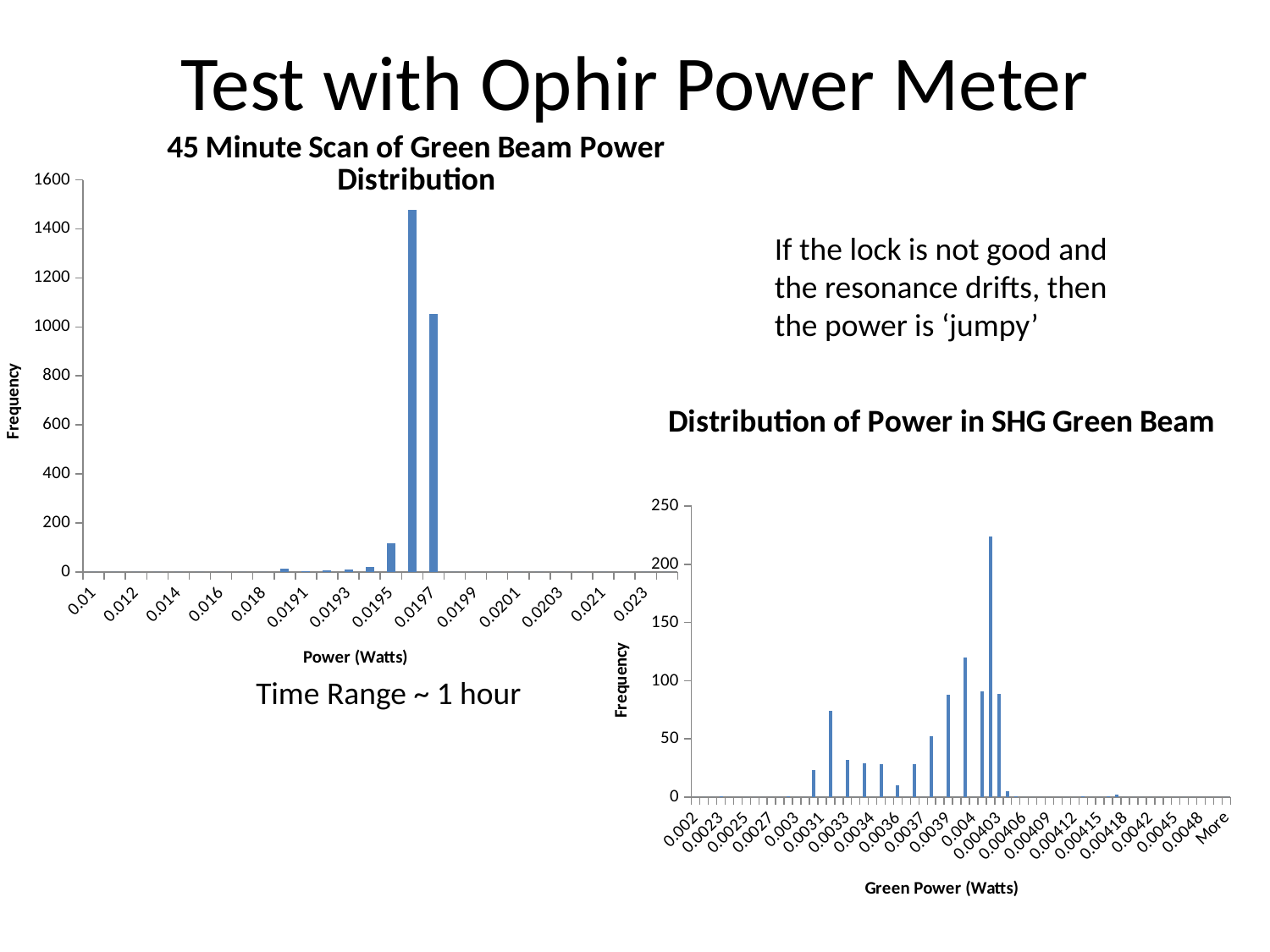
What is the x-axis title of the '45 Minute Scan of Green Beam Power Distribution' chart? Power (Watts) In the 'Distribution of Power in SHG Green Beam' chart, is the bar at 0.0033 greater or less than 50? less What kind of chart is the '45 Minute Scan of Green Beam Power Distribution' chart? bar chart In the '45 Minute Scan of Green Beam Power Distribution' chart, is the second-tallest bar greater or less than 1200? less In the 'Distribution of Power in SHG Green Beam' chart, is the tallest bar greater or less than 200? greater What is the x-axis title of the 'Distribution of Power in SHG Green Beam' chart? Green Power (Watts) What kind of chart is the 'Distribution of Power in SHG Green Beam' chart? bar chart